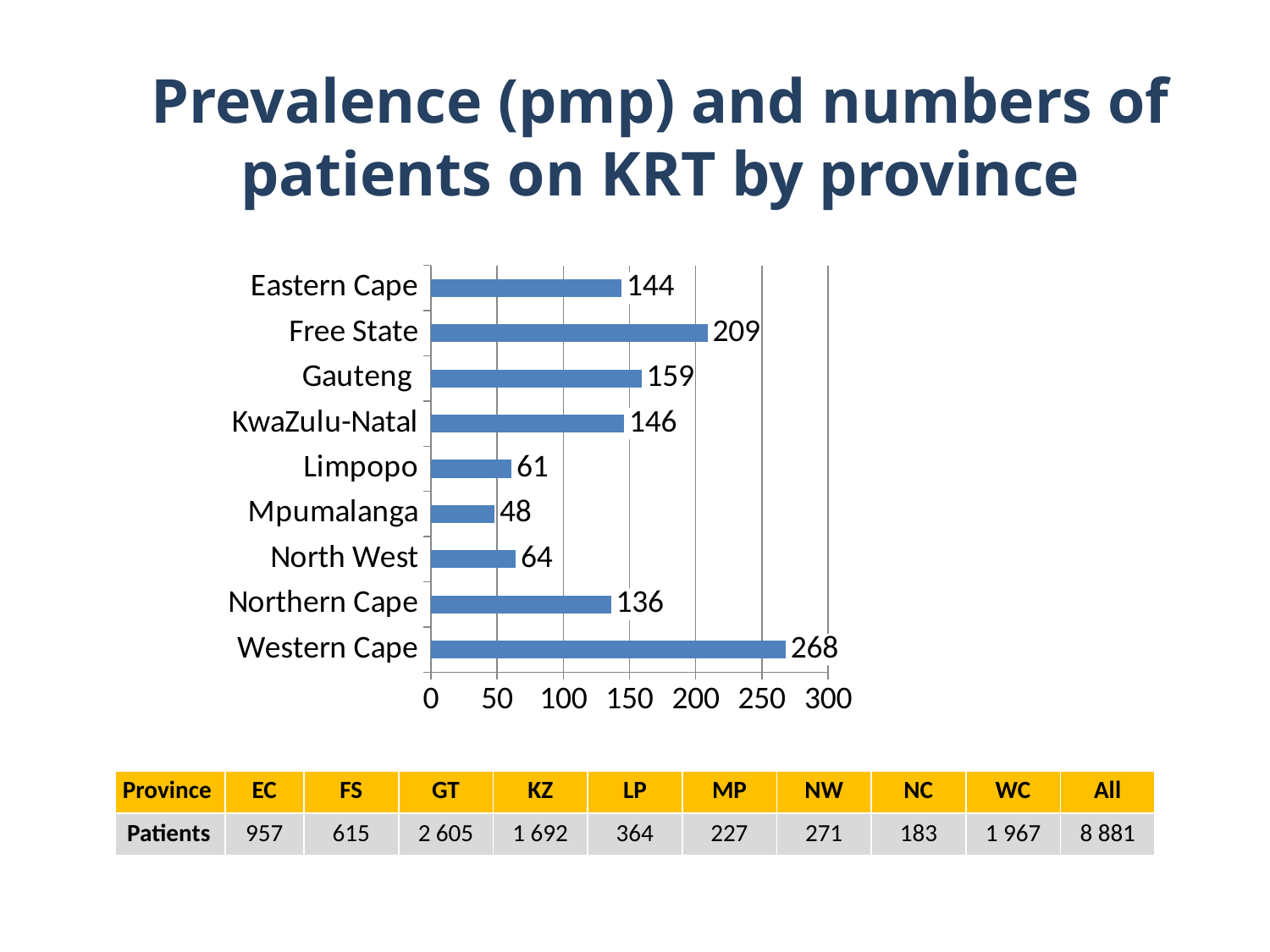
What is the maximum value shown on the horizontal axis of the chart? 300 What is the difference between the prevalence values for Western Cape and Free State? 59 What is the prevalence (pmp) value shown for Western Cape? 268 How many provinces are shown in the chart? 9 Which province has the highest prevalence (pmp) in the chart? Western Cape What is the prevalence (pmp) value shown for Free State? 209 Is the prevalence value for Northern Cape greater or less than 150? less What kind of chart is shown on the slide? bar chart What is the difference between the prevalence values for North West and Limpopo? 3 Which has a higher prevalence (pmp), Gauteng or KwaZulu-Natal? Gauteng What is the prevalence (pmp) value shown for Mpumalanga? 48 Which province has the lowest prevalence (pmp) in the chart? Mpumalanga